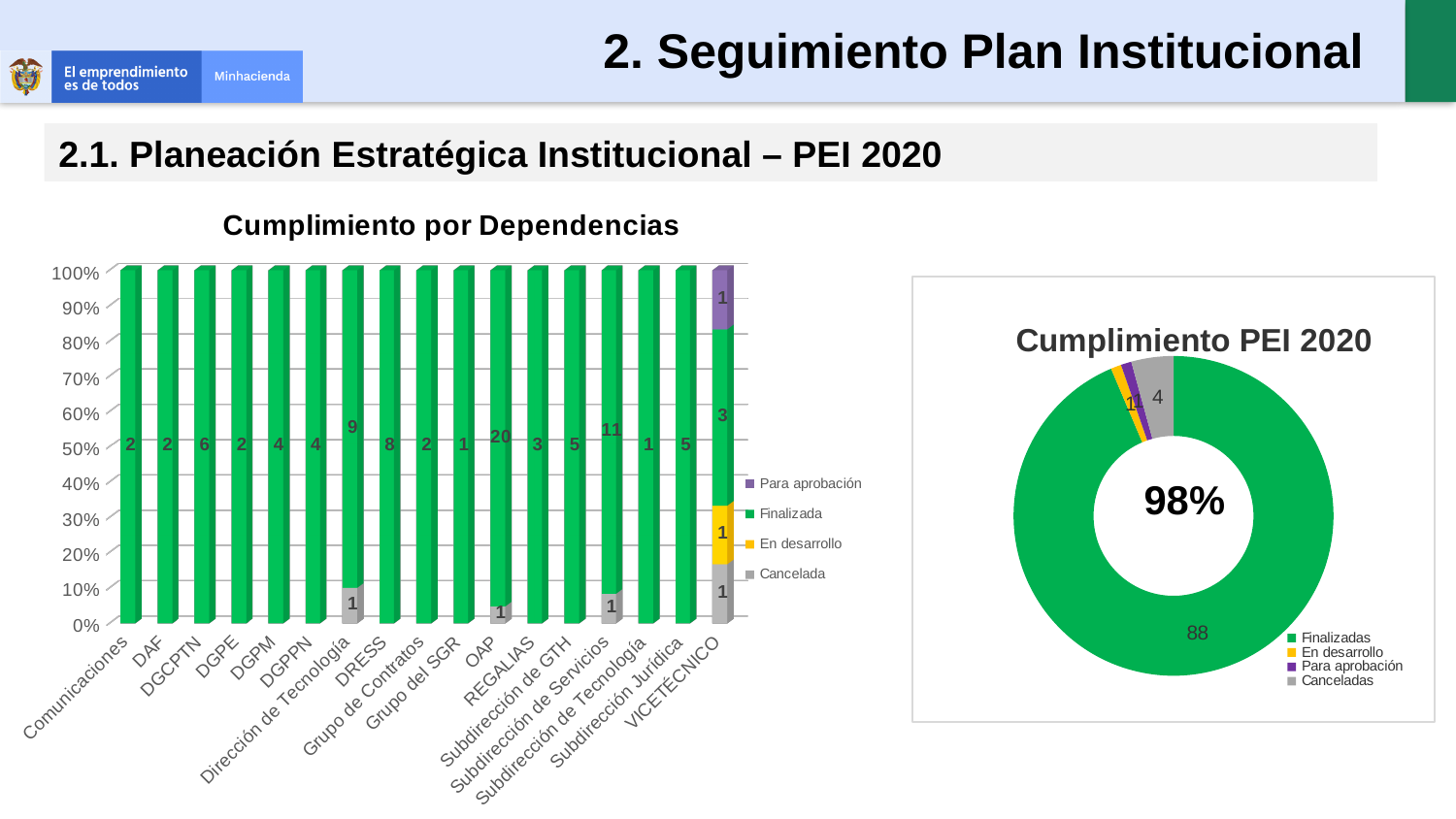
In the 'Cumplimiento por Dependencias' chart, what is the Finalizada value for Subdirección de Servicios? 11 In the 'Cumplimiento por Dependencias' chart, which dependency has the highest Finalizada value? OAP What percentage is shown in the centre of the 'Cumplimiento PEI 2020' chart? 98% In the 'Cumplimiento por Dependencias' chart, what is the total of the VICETÉCNICO bar across all series? 6 What kind of chart is the 'Cumplimiento PEI 2020' chart on the right? Doughnut chart In the 'Cumplimiento por Dependencias' chart, what is the difference between the Finalizada values for OAP and Subdirección de Servicios? 9 In the 'Cumplimiento PEI 2020' chart, what is the value for Finalizadas? 88 What kind of chart is the 'Cumplimiento por Dependencias' chart on the left? Stacked bar chart In the 'Cumplimiento PEI 2020' chart, what is the value for Canceladas? 4 How many dependencies are shown on the x axis of the 'Cumplimiento por Dependencias' chart? 17 How many series does the legend of the 'Cumplimiento por Dependencias' chart list? 4 In the 'Cumplimiento por Dependencias' chart, what is the Finalizada value for OAP? 20